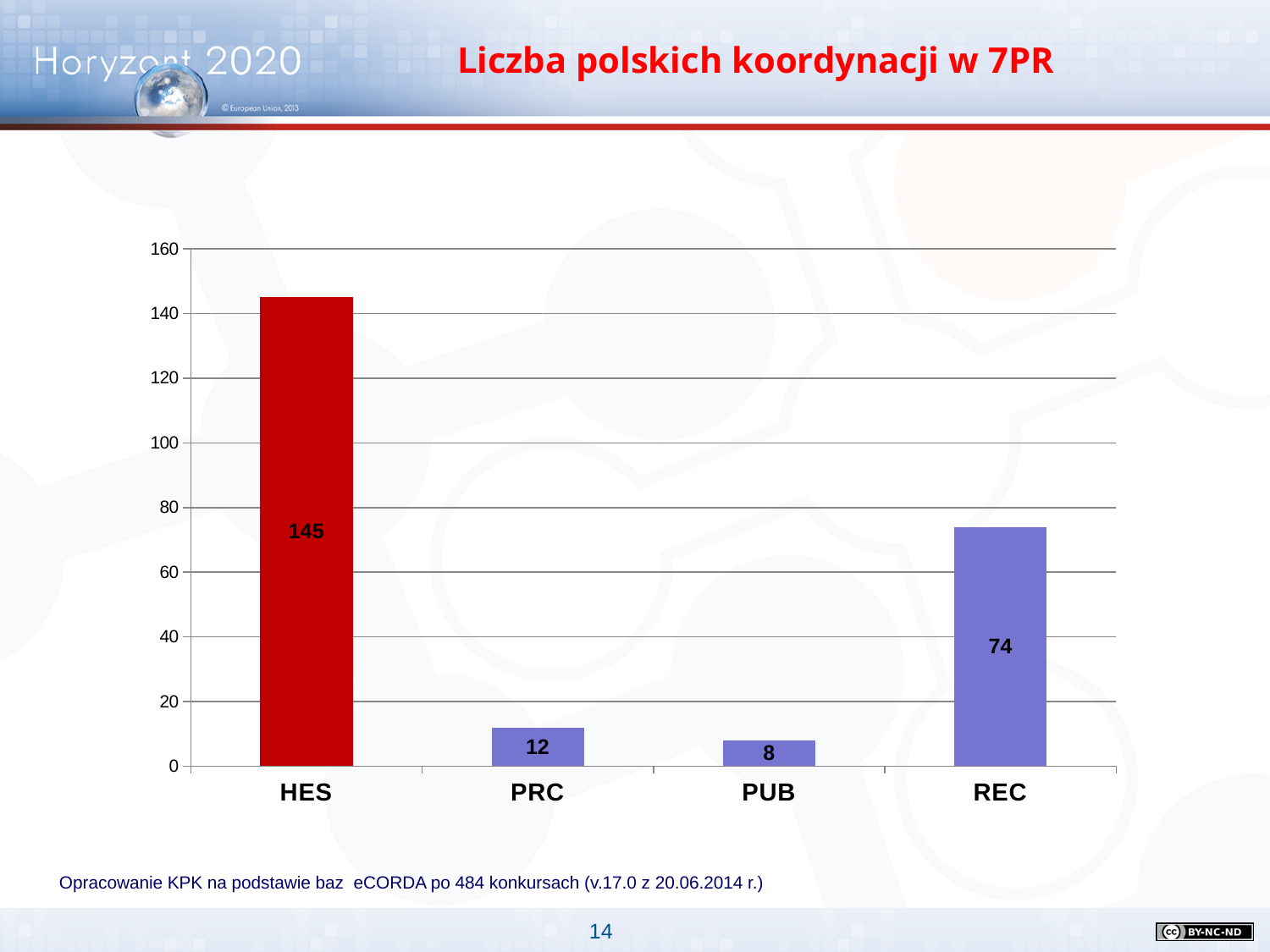
Which is larger, the value for PRC or the value for PUB? PRC How many categories are shown on the x axis? 4 What is the value for PRC? 12 What kind of chart is shown on the slide? bar chart What is the difference between the values for HES and REC? 71 What is the title of the chart? Liczba polskich koordynacji w 7PR What is the value for PUB? 8 Which category has the lowest value? PUB Which category has the highest value? HES What is the value for REC? 74 What is the value for HES? 145 Is the value for REC greater or less than 60? greater